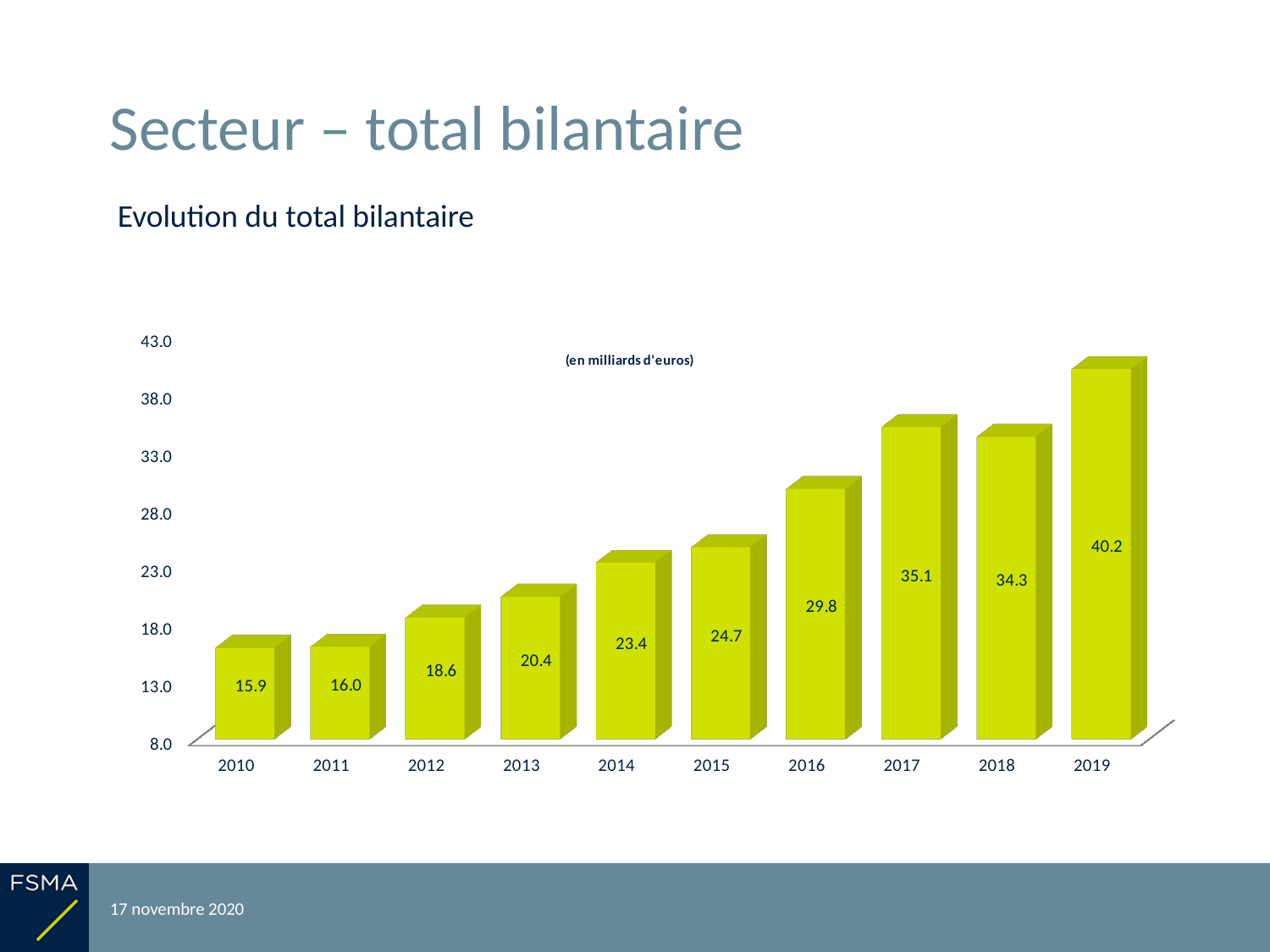
Which year has the lowest value? 2010 What is the difference between the values for 2019 and 2010? 24.3 What is the value for 2010? 15.9 How many years are shown on the x axis? 10 What kind of chart is shown? bar chart Which year has the highest value? 2019 Is the value for 2016 greater or less than 28.0? greater What is the value for 2018? 34.3 What is the difference between the values for 2017 and 2018? 0.8 What unit is stated in the chart's label? en milliards d'euros Which is larger, the value for 2017 or the value for 2018? 2017 What is the value for 2015? 24.7